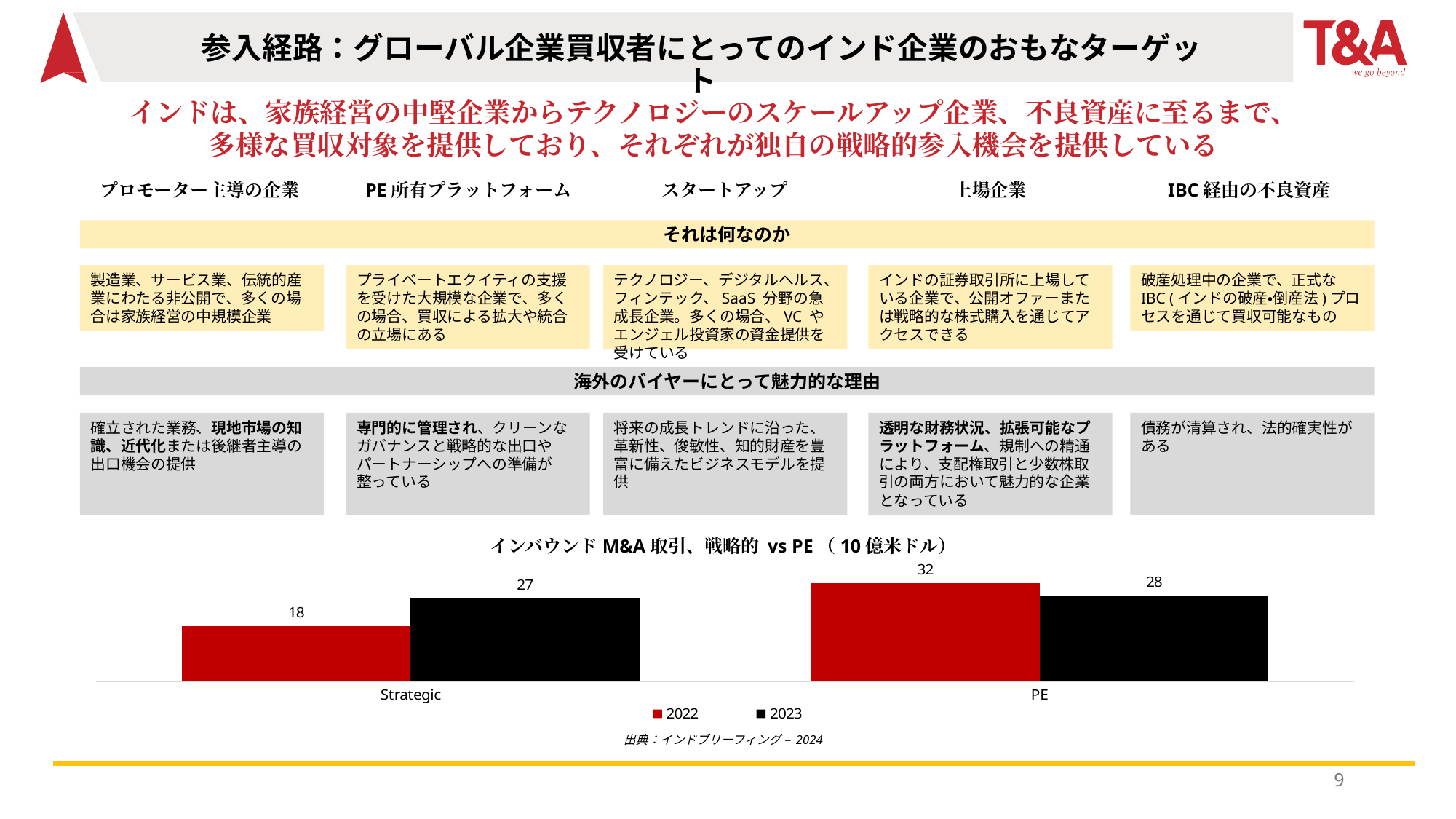
What kind of chart is shown on the slide? Bar chart Which is larger for PE, the 2022 value or the 2023 value? 2022 Which category has the lowest value in 2023? Strategic How many categories are shown on the x axis? 2 What is the value for Strategic in 2023? 27 What is the difference between the 2022 and 2023 values for PE? 4 What is the value for Strategic in 2022? 18 What is the value for PE in 2023? 28 What is the value for PE in 2022? 32 How many series does the legend list? 2 Which category has the highest value in 2022? PE What is the difference between the 2023 and 2022 values for Strategic? 9